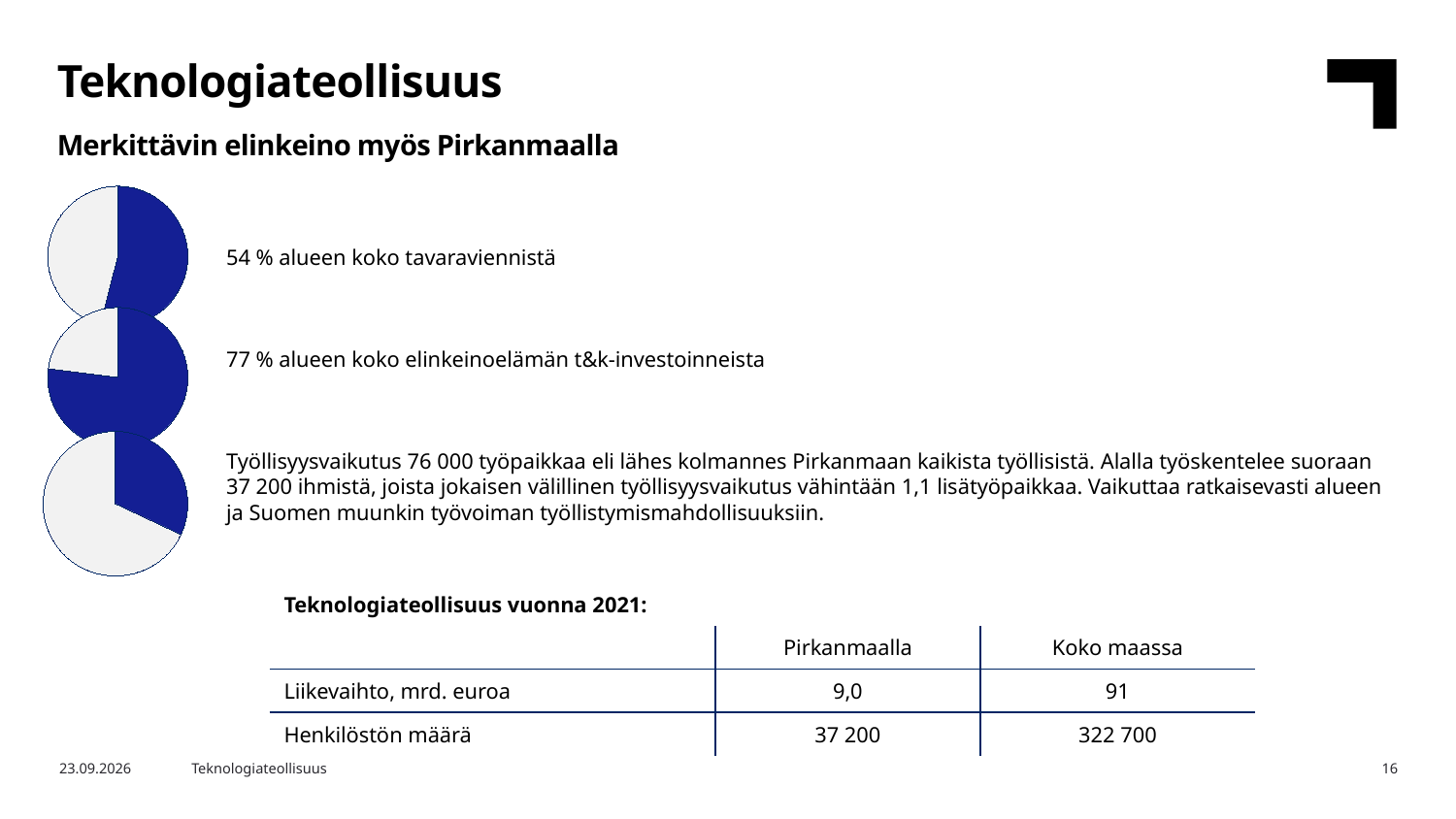
How many pie charts are on the slide? 3 What kind of charts are shown on the left side of the slide? Pie charts According to the text next to the middle pie chart, what share of the region's business R&D investments does the highlighted slice represent? 77 % What is the title of the slide that contains the pie charts? Teknologiateollisuus How many slices does each pie chart on the slide have? 2 According to the text next to the top pie chart, what share of the region's total goods exports does the highlighted slice represent? 54 % What colour is the highlighted slice in the pie charts? Dark blue Is the highlighted slice larger in the top pie chart or in the bottom pie chart? The top pie chart Which of the three pie charts has the largest highlighted (blue) slice? The middle pie chart Which of the three pie charts has the smallest highlighted (blue) slice? The bottom pie chart